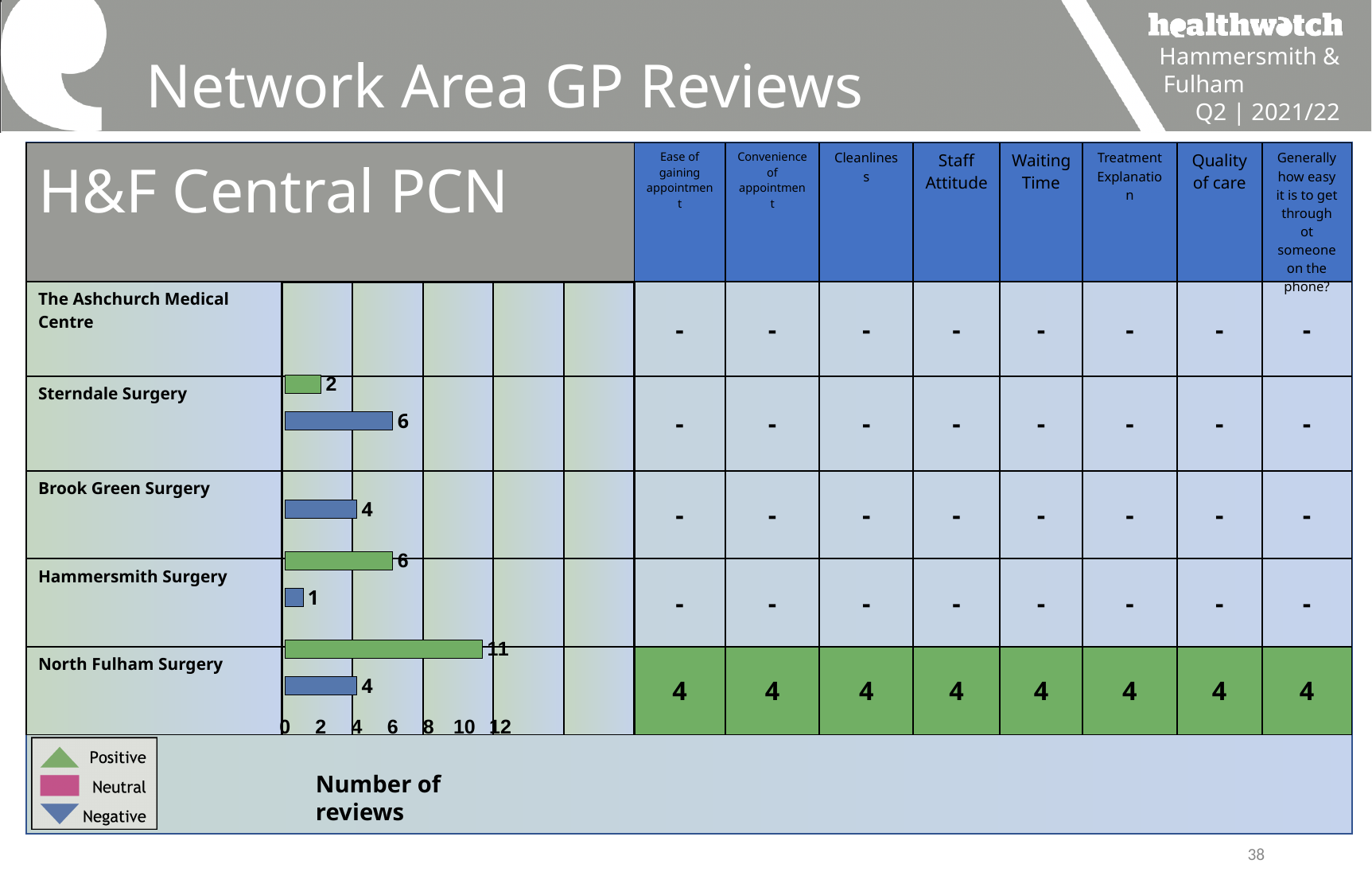
Which surgery has the highest number of positive reviews? North Fulham Surgery Which surgery has the lowest number of negative reviews among those with a negative bar? Hammersmith Surgery How many positive reviews does Hammersmith Surgery have? 6 Is the number of positive reviews for North Fulham Surgery greater or less than 10? greater How many negative reviews does Sterndale Surgery have? 6 How many positive reviews does North Fulham Surgery have? 11 What kind of chart is used to show the number of reviews? bar chart Which is larger for Sterndale Surgery, positive reviews or negative reviews? negative reviews Which legend entry is shown in green on the number of reviews chart? Positive How many negative reviews does Brook Green Surgery have? 4 What is the difference between positive and negative reviews for North Fulham Surgery? 7 How many series does the legend of the number of reviews chart list? 3